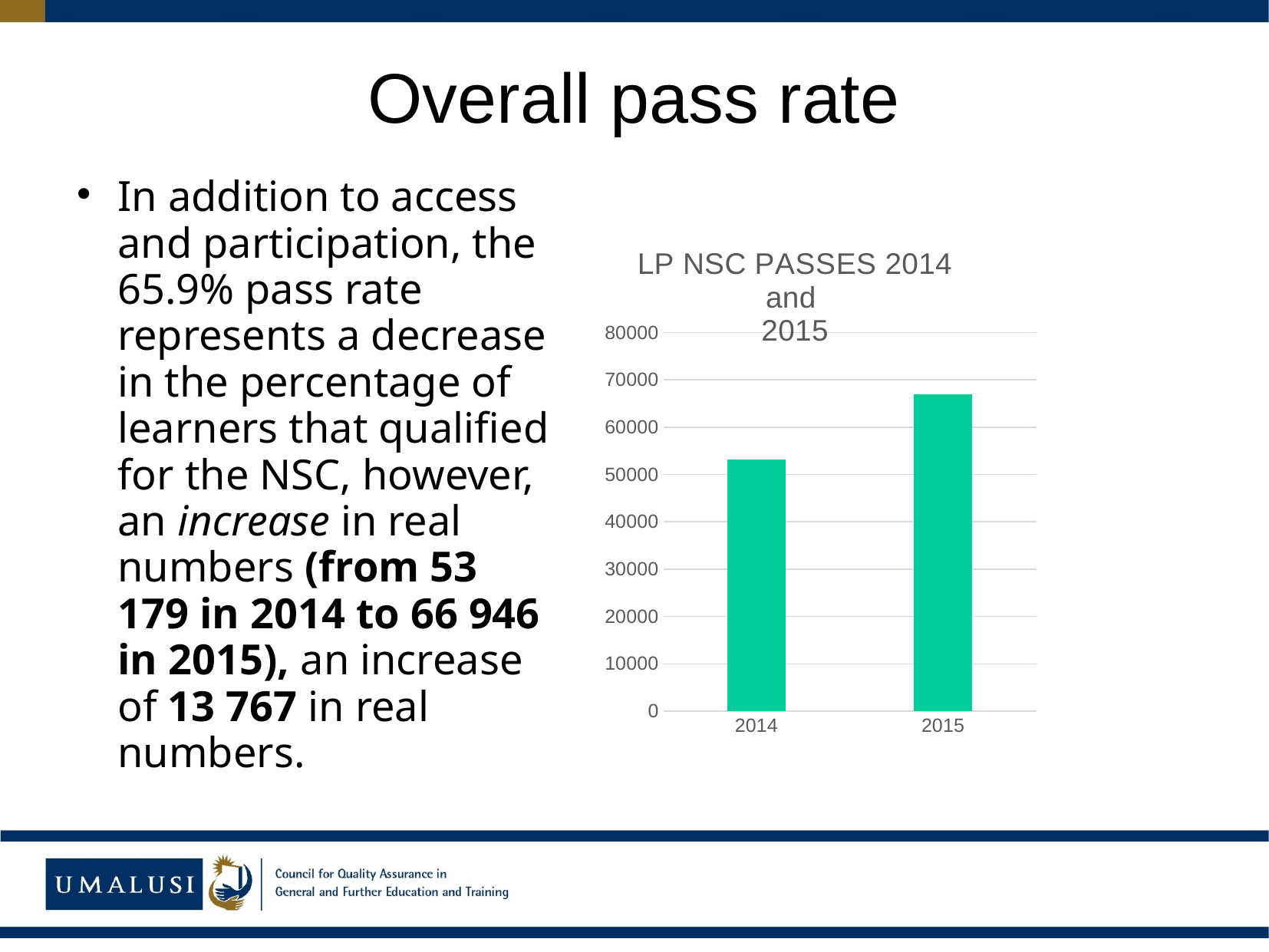
Which year has the higher number of passes in the chart? 2015 Is the value for 2014 greater or less than 60000? less Is the bar for 2015 taller or shorter than the bar for 2014? taller What is the highest value shown on the vertical axis of the chart? 80000 Which year has the lower number of passes in the chart? 2014 What is the title of the chart? LP NSC PASSES 2014 and 2015 How many bars are plotted in the chart? 2 Is the value for 2014 greater or less than 50000? greater What type of chart is shown on the slide? bar chart Is the value for 2015 greater or less than 60000? greater Do the values rise or fall from 2014 to 2015? rise